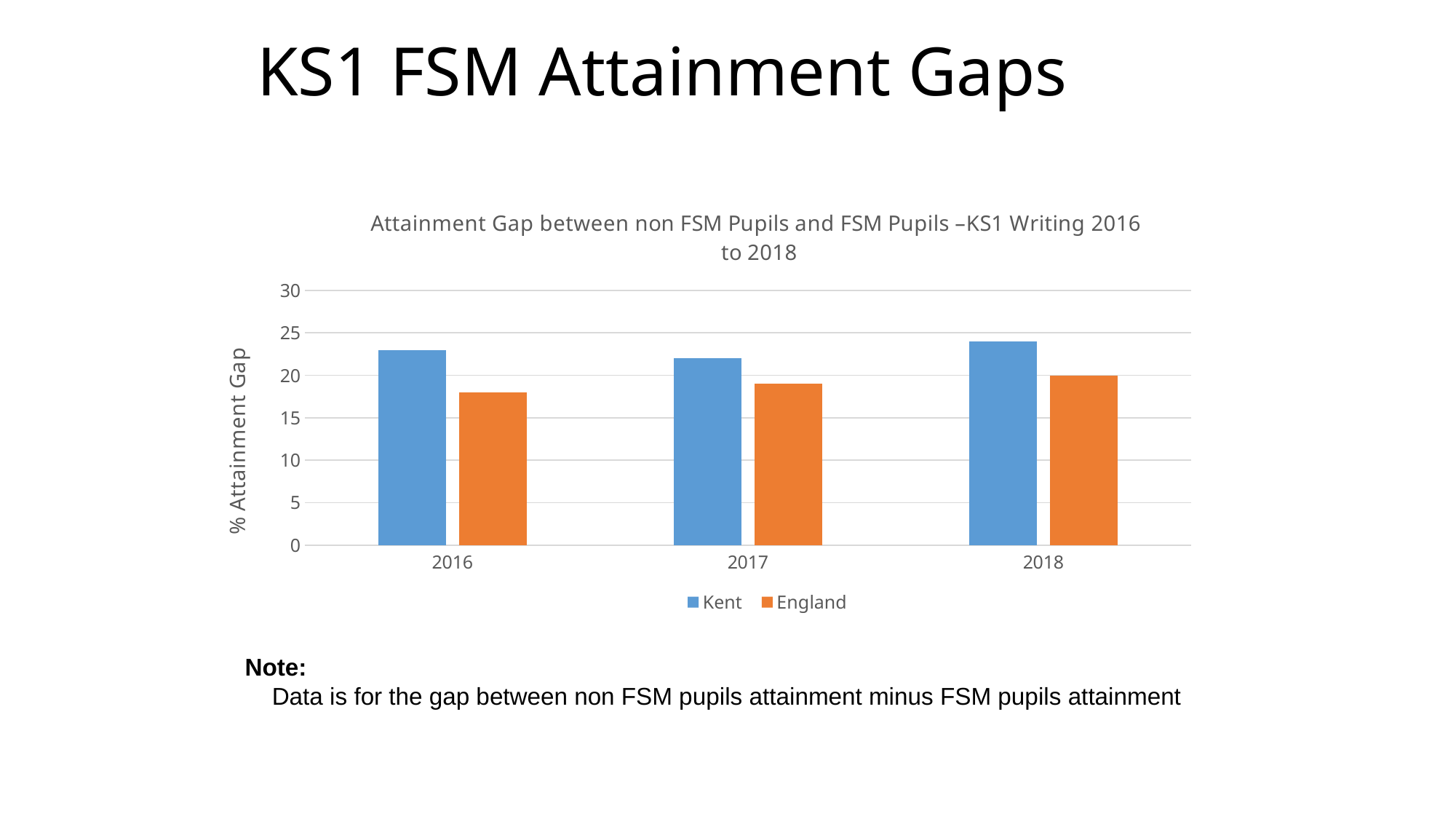
Is the value for Kent in 2016 greater or less than 20? greater In 2017, which is larger, the attainment gap for Kent or for England? Kent Is the value for Kent in 2018 greater or less than 25? less What kind of chart is shown on the slide? bar chart Is the value for England in 2016 greater or less than 20? less What is the label on the y axis? % Attainment Gap How many series does the legend list? 2 How many years are shown on the x axis? 3 Does the England attainment gap rise or fall from 2016 to 2018? rise In which year is the England attainment gap highest? 2018 In which year is the Kent attainment gap lowest? 2017